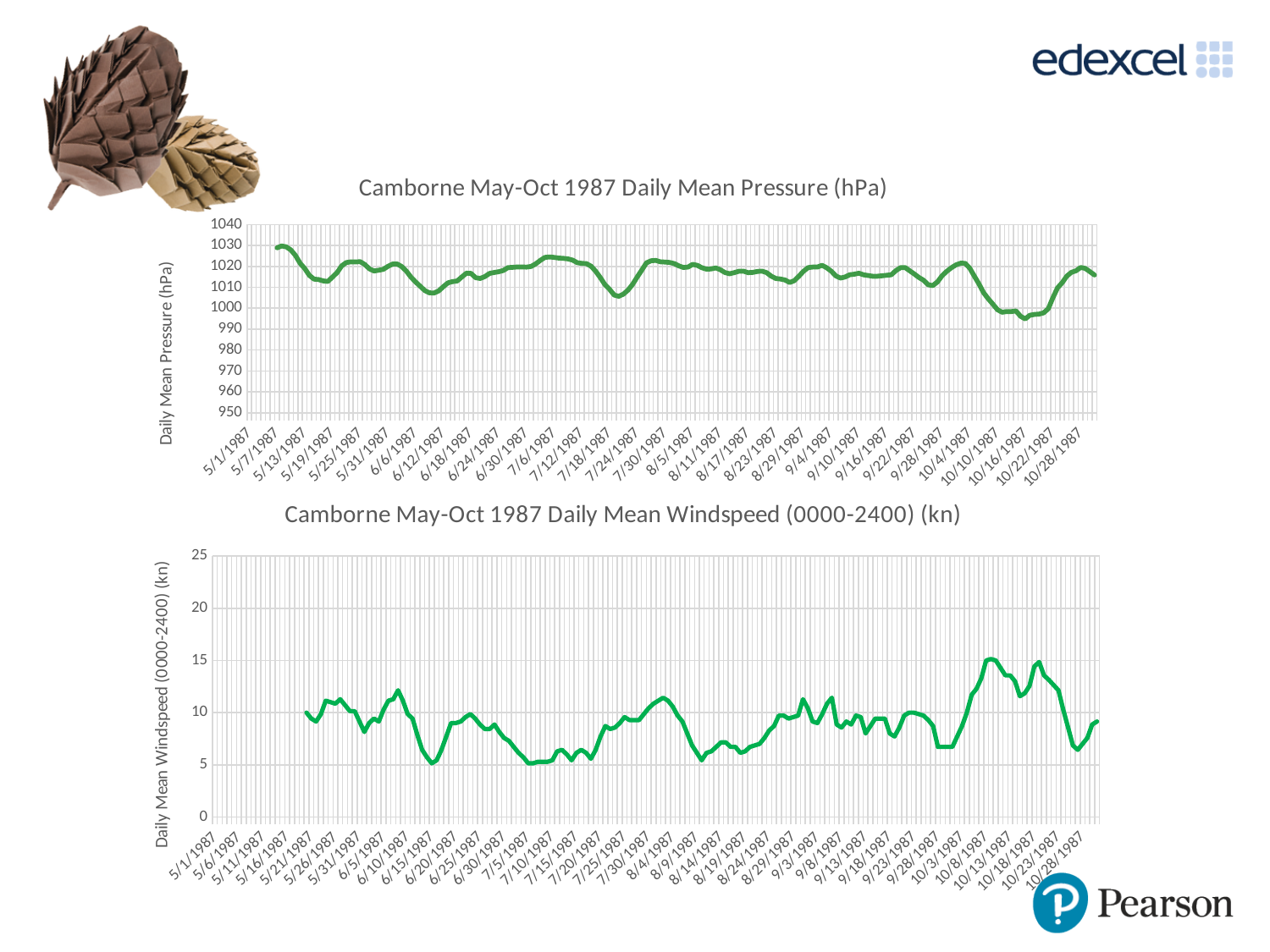
What is the y-axis label of the bottom chart on the slide? Daily Mean Windspeed (0000-2400) (kn) In the Daily Mean Windspeed chart, is the peak value around 10/8/1987 greater or less than 10? greater In the Daily Mean Windspeed chart, is the value around 7/10/1987 greater or less than 10? less In the Daily Mean Pressure chart, is the value around 7/18/1987 greater or less than 1010? less What is the title of the top chart on the slide? Camborne May-Oct 1987 Daily Mean Pressure (hPa) In the Daily Mean Pressure chart, does the line rise or fall between 10/4/1987 and 10/16/1987? fall What kind of chart is the Camborne May-Oct 1987 Daily Mean Windspeed chart? line chart What kind of chart is the Camborne May-Oct 1987 Daily Mean Pressure chart? line chart In the Daily Mean Windspeed chart, does the line rise or fall between 9/28/1987 and 10/8/1987? rise